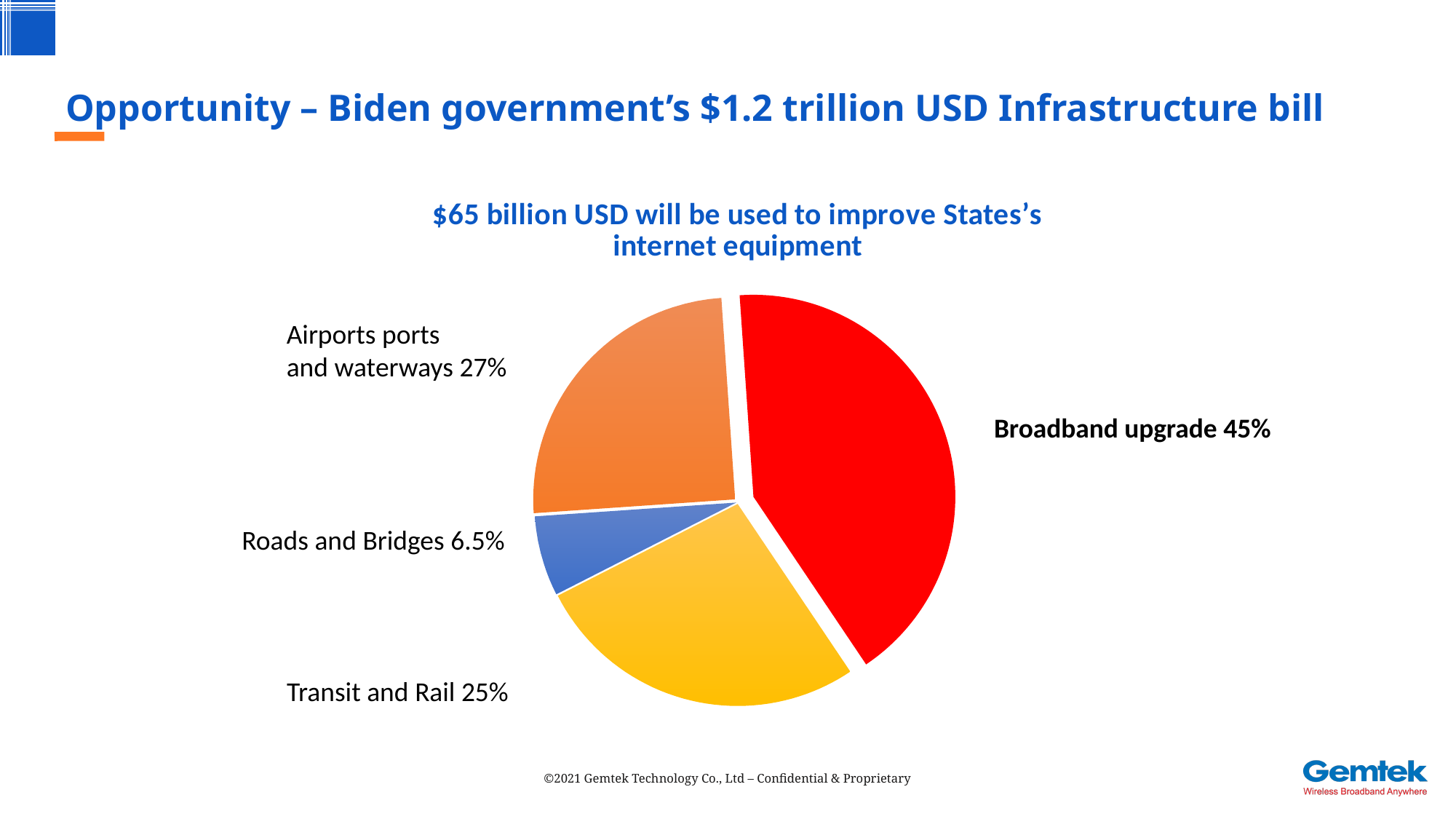
Which is larger, the share for Airports ports and waterways or the share for Transit and Rail? Airports ports and waterways What is the difference between the Airports ports and waterways share and the Roads and Bridges share? 20.5% What colour is the Broadband upgrade slice? Red What share of the pie does Broadband upgrade represent? 45% Which category has the largest slice of the pie? Broadband upgrade What is the value shown for Transit and Rail? 25% What is the value shown for Roads and Bridges? 6.5% Which category has the smallest slice of the pie? Roads and Bridges What is the value shown for Airports ports and waterways? 27% What kind of chart is shown on the slide? Pie chart How many slices does the pie chart have? 4 What is the difference between the Broadband upgrade share and the Transit and Rail share? 20%